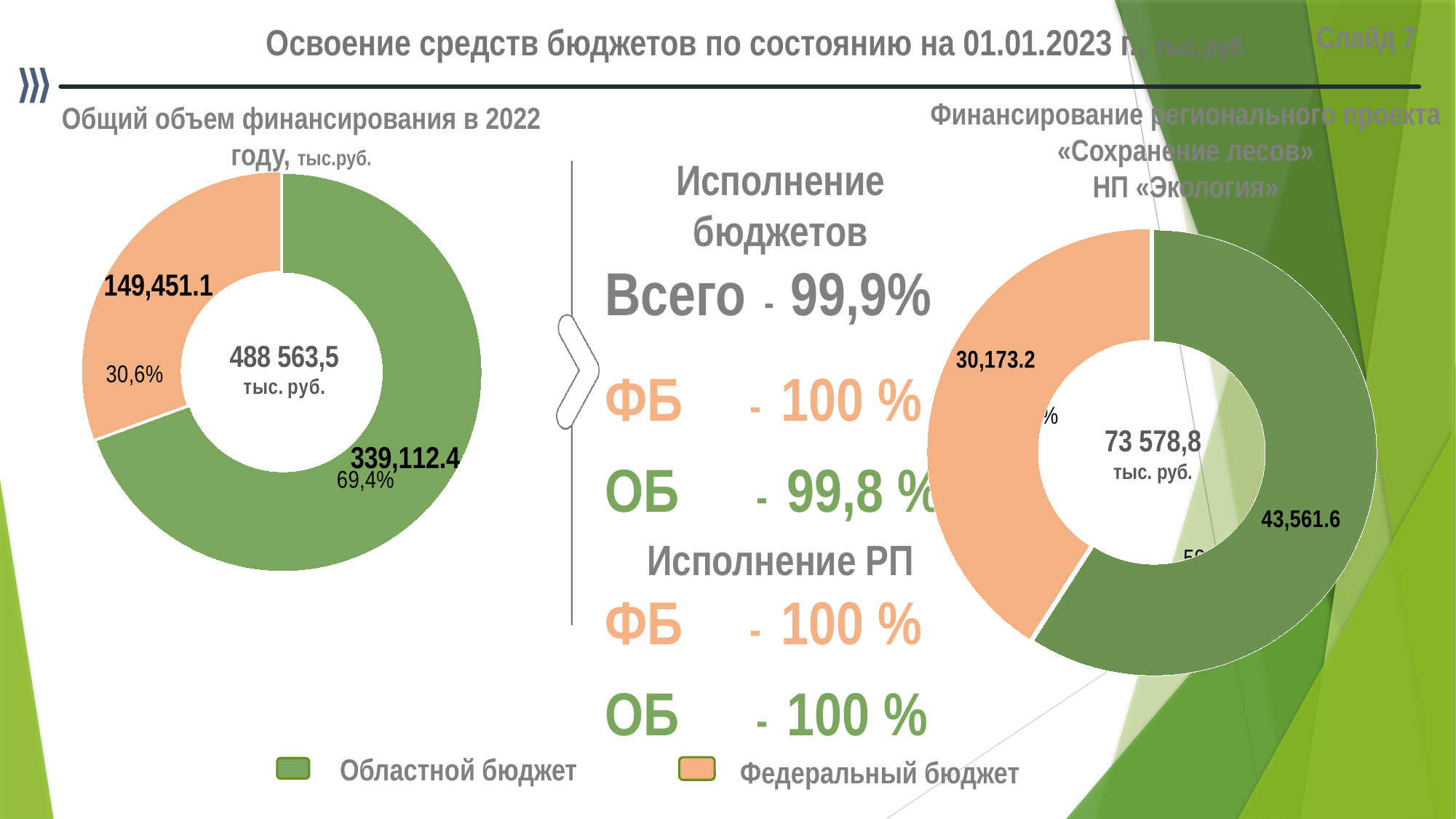
In the chart "Общий объем финансирования в 2022 году", which budget has the larger value? Областной бюджет What kind of chart is used for "Общий объем финансирования в 2022 году"? Pie (doughnut) chart In the chart "Финансирование регионального проекта «Сохранение лесов» НП «Экология»", what is the value for Областной бюджет? 43,561.6 In the chart "Общий объем финансирования в 2022 году", what share of the total does Федеральный бюджет represent? 30,6% In the chart "Общий объем финансирования в 2022 году", what is the value for Федеральный бюджет? 149,451.1 In the chart "Общий объем финансирования в 2022 году", what total is shown in the centre of the doughnut? 488 563,5 тыс. руб. In the chart "Общий объем финансирования в 2022 году", what share of the total does Областной бюджет represent? 69,4% How many entries does the shared legend at the bottom of the slide list? 2 In the chart "Финансирование регионального проекта «Сохранение лесов» НП «Экология»", which budget has the smaller value? Федеральный бюджет In the chart "Финансирование регионального проекта «Сохранение лесов» НП «Экология»", what is the value for Федеральный бюджет? 30,173.2 In the chart "Финансирование регионального проекта «Сохранение лесов» НП «Экология»", what total is shown in the centre of the doughnut? 73 578,8 тыс. руб. In the chart "Общий объем финансирования в 2022 году", what is the value for Областной бюджет? 339,112.4